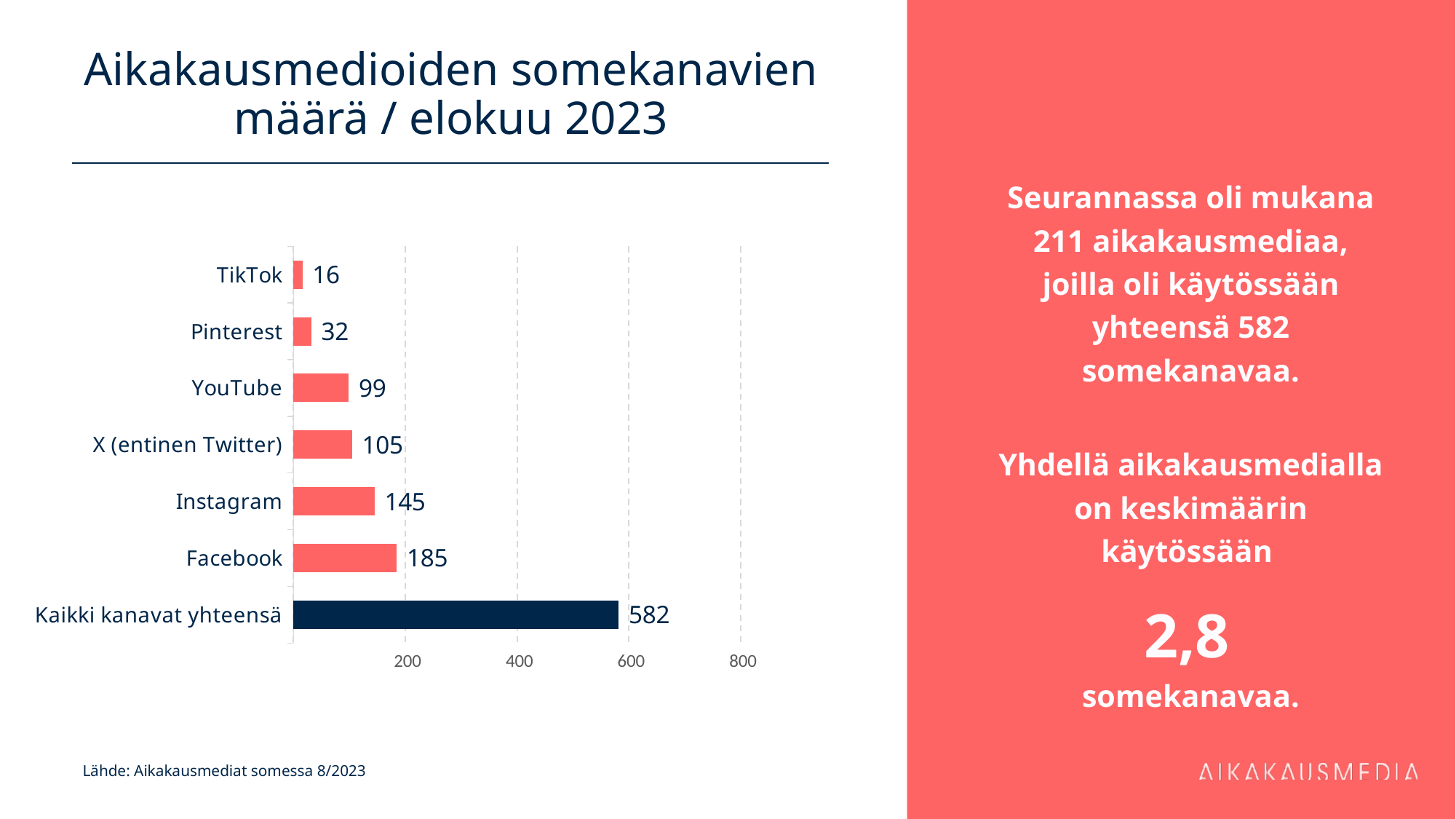
Which is larger, the value for YouTube or the value for Pinterest? YouTube Which category has the lowest value? TikTok What is the title of the chart? Aikakausmedioiden somekanavien määrä / elokuu 2023 What is the value for TikTok? 16 What is the value for Kaikki kanavat yhteensä? 582 What is the difference between the values for Facebook and Instagram? 40 How many bars are shown in the chart? 7 Which individual channel (excluding the total bar) has the highest value? Facebook What is the value for X (entinen Twitter)? 105 Is the value for Instagram greater or less than 200? less What kind of chart is shown on the slide? Bar chart What is the value for Facebook? 185